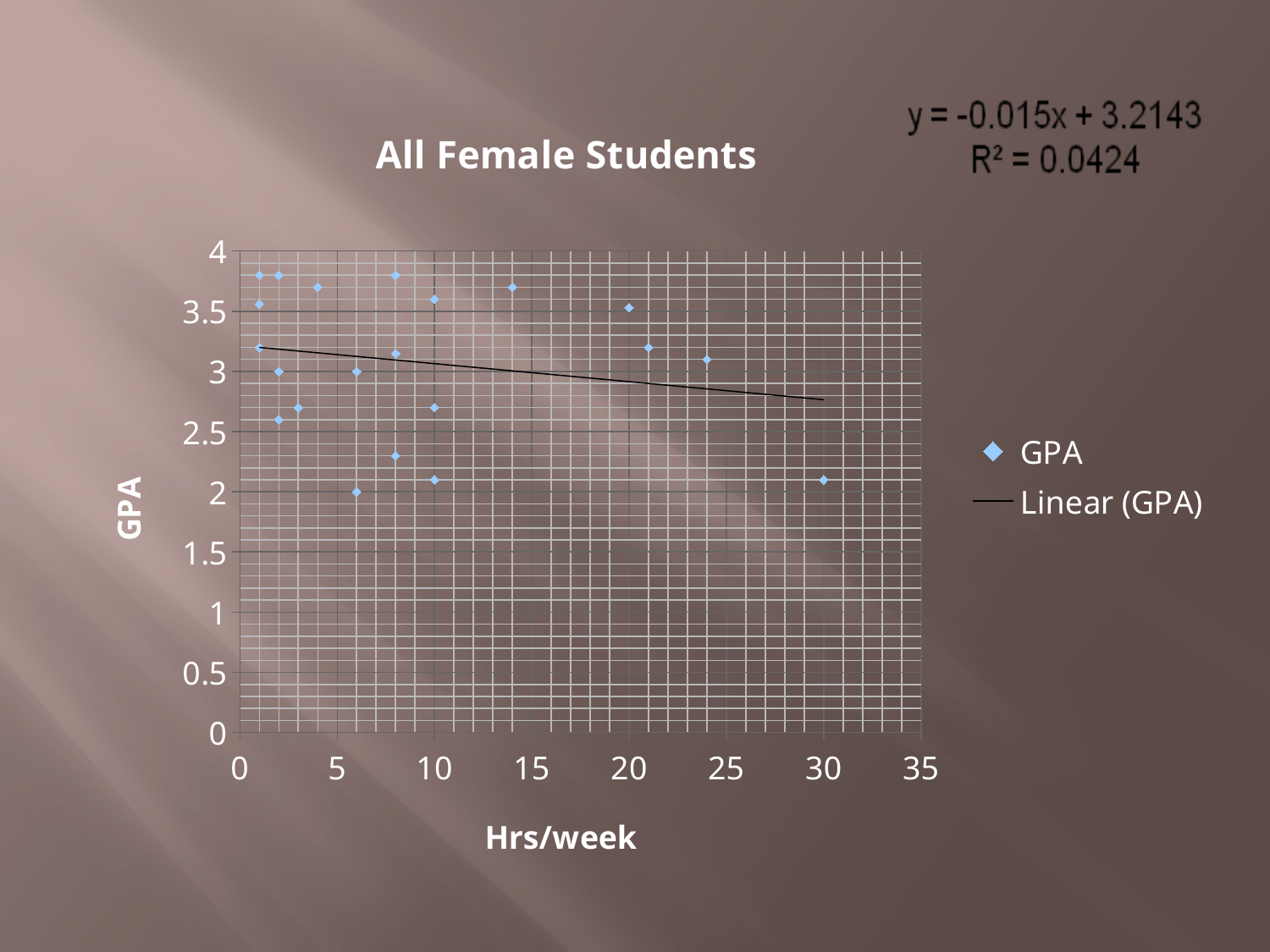
Does the linear trendline rise or fall as Hrs/week increases? Fall How many series does the legend list? 2 What is the equation of the trendline shown on the slide? y = -0.015x + 3.2143 Is the GPA value for the point at 14 Hrs/week greater or less than 3.5? greater What is the label of the y axis? GPA Is the GPA value for the point at 30 Hrs/week greater or less than 2.5? less Which has the higher GPA: the point at 14 Hrs/week or the point at 30 Hrs/week? 14 Hrs/week What is the label of the x axis? Hrs/week What is the R² value shown for the trendline? 0.0424 What type of chart is shown on the slide? Scatter chart What is the title of the chart? All Female Students What are the two entries in the chart legend? GPA and Linear (GPA)